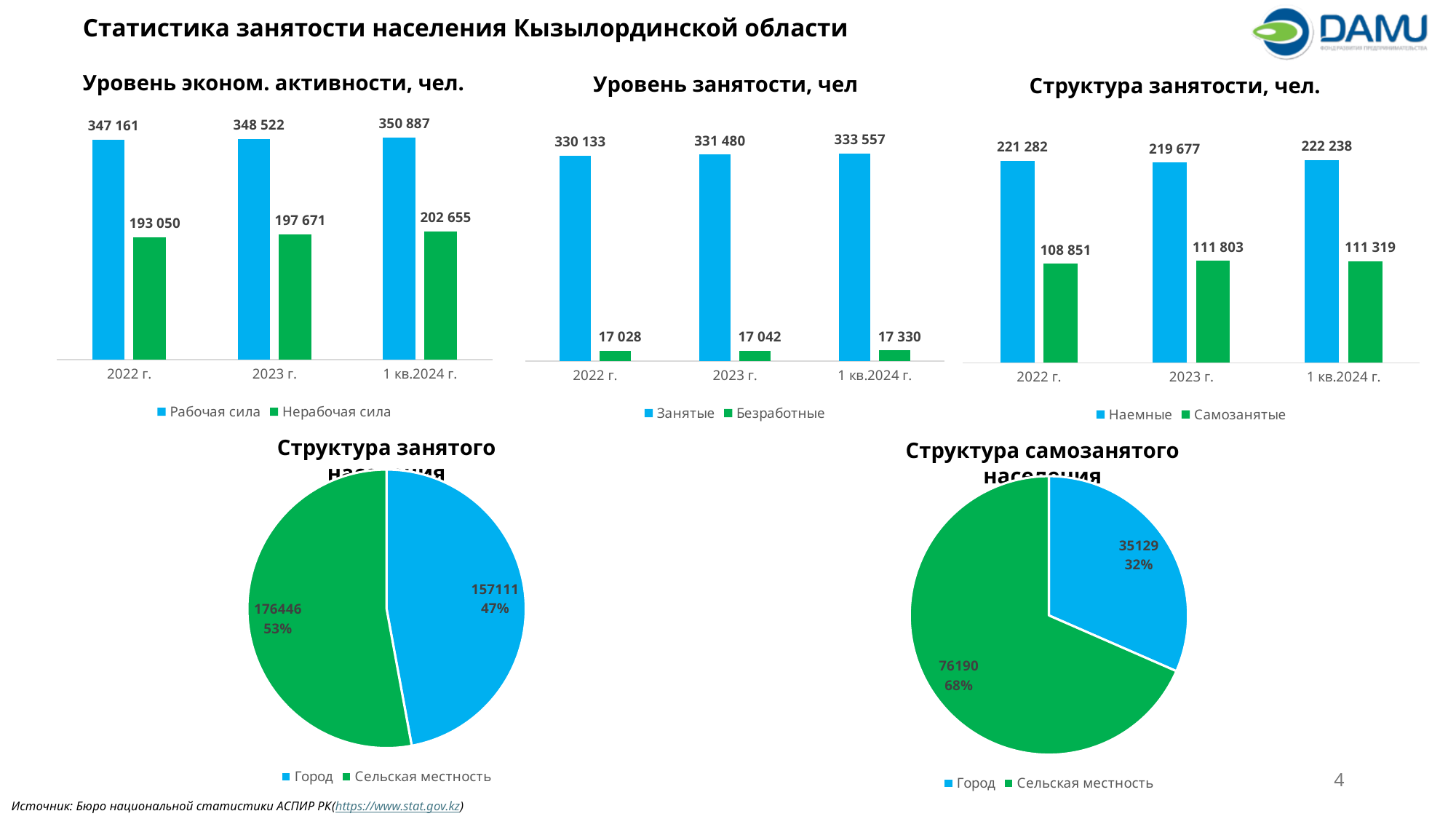
In the chart 'Структура занятости, чел.', which period has the lowest value for 'Наемные'? 2023 г. In the chart 'Структура самозанятого населения', which slice is larger, 'Город' or 'Сельская местность'? Сельская местность In the chart 'Структура занятости, чел.', how many series does the legend list? 2 In the chart 'Уровень занятости, чел', what is the value of 'Безработные' for 2022 г.? 17 028 In the chart 'Структура самозанятого населения', what is the value for 'Город'? 35129 In the chart 'Уровень занятости, чел', do the values of 'Занятые' rise or fall from 2022 г. to 1 кв.2024 г.? rise In the chart 'Структура занятого населения', what share does 'Сельская местность' have? 53% In the chart 'Уровень эконом. активности, чел.', what is the value of 'Рабочая сила' for 2023 г.? 348 522 In the chart 'Уровень эконом. активности, чел.', what is the value of 'Нерабочая сила' for 1 кв.2024 г.? 202 655 In the chart 'Структура занятости, чел.', what is the value of 'Самозанятые' for 2023 г.? 111 803 What kind of chart is 'Структура занятого населения'? pie chart In the chart 'Уровень занятости, чел', what is the difference between 'Занятые' and 'Безработные' for 1 кв.2024 г.? 316 227